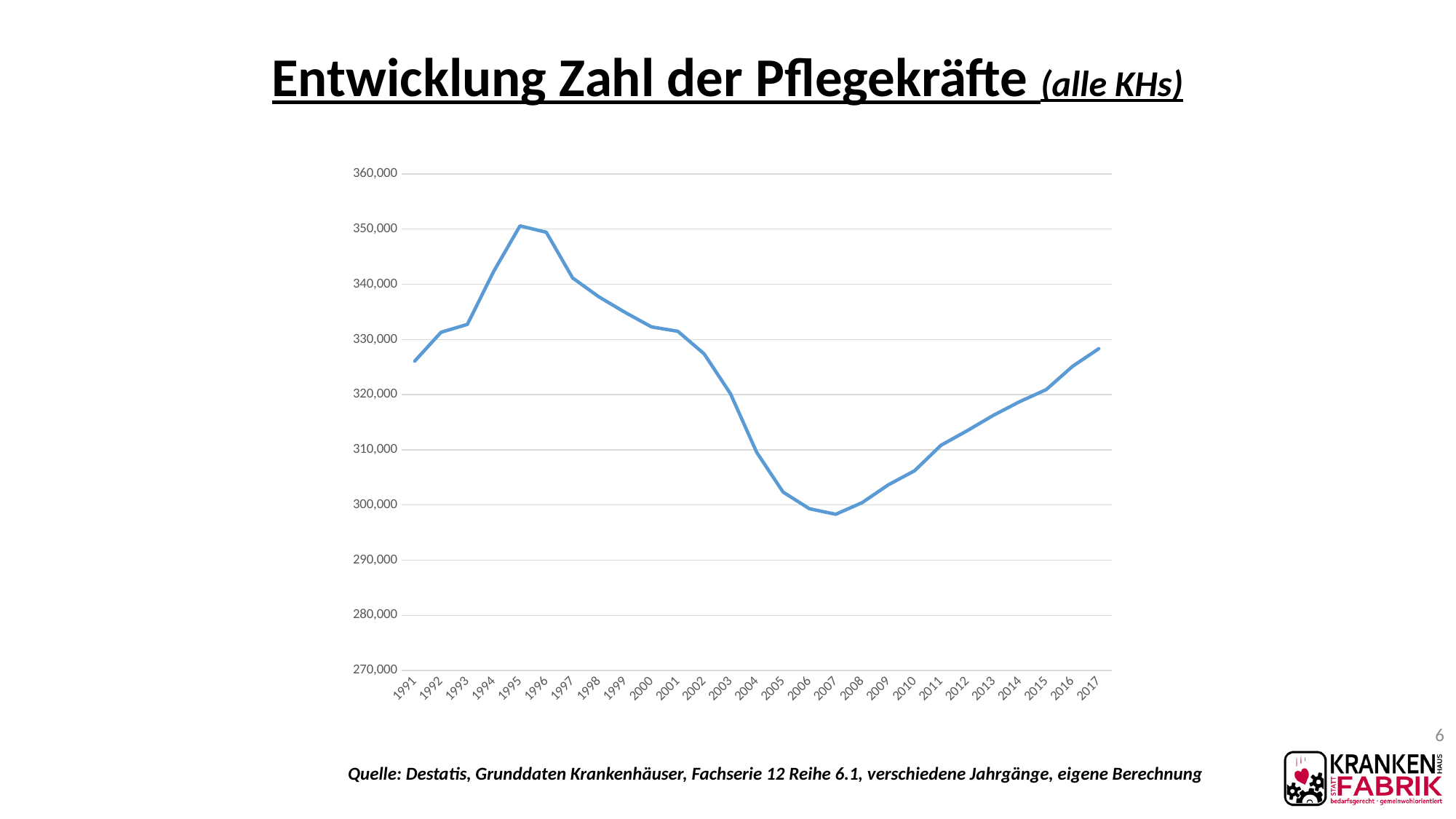
Is the value for 1991 greater or less than 320,000? greater What kind of chart is shown on the slide? line chart How many years are plotted on the x axis? 27 In which year does the number of nursing staff reach its highest point? 1995 In which year does the number of nursing staff reach its lowest point? 2007 Is the value for 2004 greater or less than 320,000? less What is the title of the chart? Entwicklung Zahl der Pflegekräfte (alle KHs) Which year has the larger value, 1999 or 2014? 1999 Which year has the larger value, 2003 or 2010? 2003 Do the values rise or fall between 1995 and 2007? fall Is the value for 1994 greater or less than 340,000? greater